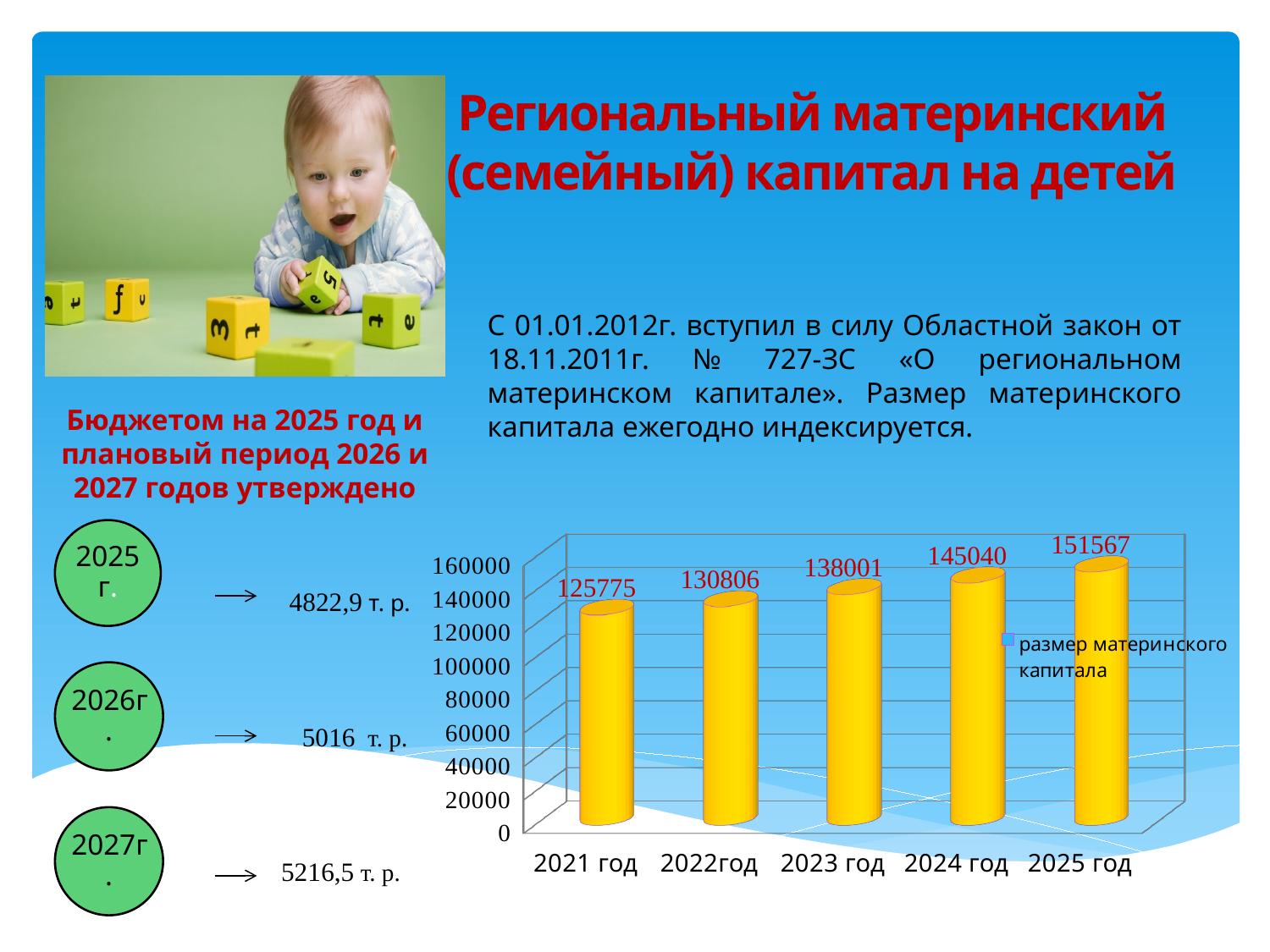
What is the value for 2021 год in the chart? 125775 Which year has the lowest value in the chart? 2021 год How many years are shown on the x axis of the chart? 5 Do the values rise or fall from 2021 год to 2025 год? rise What is the difference between the values for 2025 год and 2021 год? 25792 Which year has the highest value in the chart? 2025 год What kind of chart is shown on the slide? bar chart What is the difference between the values for 2024 год and 2023 год? 7039 What is the value for 2023 год in the chart? 138001 What is the value for 2025 год in the chart? 151567 Which is larger, the value for 2022год or the value for 2024 год? 2024 год Is the value for 2021 год greater or less than 140000? less